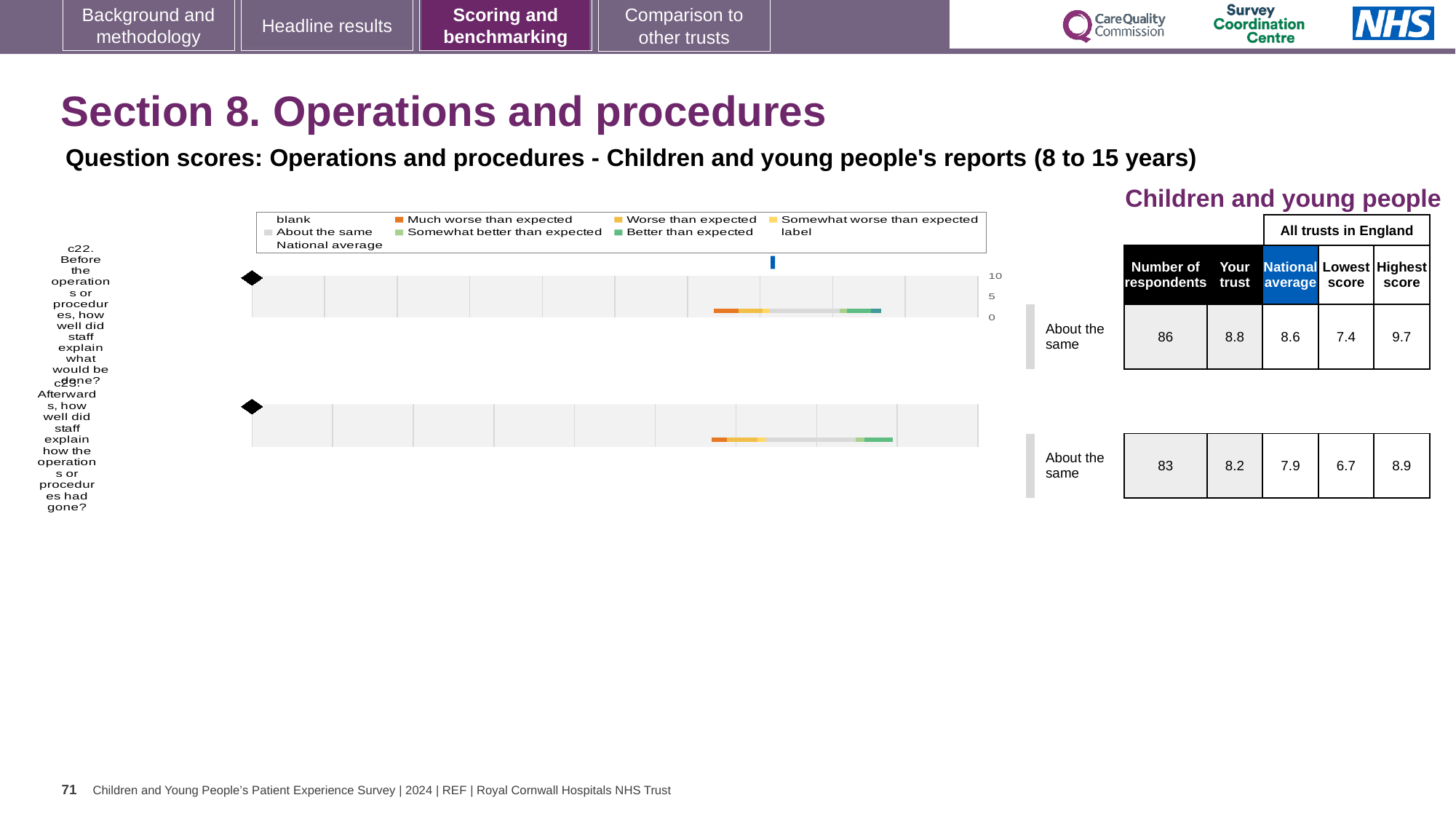
What benchmarking category is the trust placed in for question c23? About the same How many question charts (c22 and c23) are shown on the slide? 2 What is the lowest score among all trusts in England for question c22? 7.4 What kind of chart is used to show the benchmarking for question c22? Bar chart For question c23, what is the highest score among all trusts in England? 8.9 What is the difference between the 'Your trust' score and the national average for question c23? 0.3 How many respondents answered question c22? 86 What colour in the legend represents 'Much worse than expected'? Orange For question c22 (Before the operations or procedures, how well did staff explain what would be done?), what is the 'Your trust' score shown in the table? 8.8 For question c23 (Afterwards, how well did staff explain how the operations or procedures had gone?), what is the 'Your trust' score? 8.2 Which question has the higher 'Your trust' score, c22 or c23? c22 For question c22, what is the national average score shown in the table? 8.6